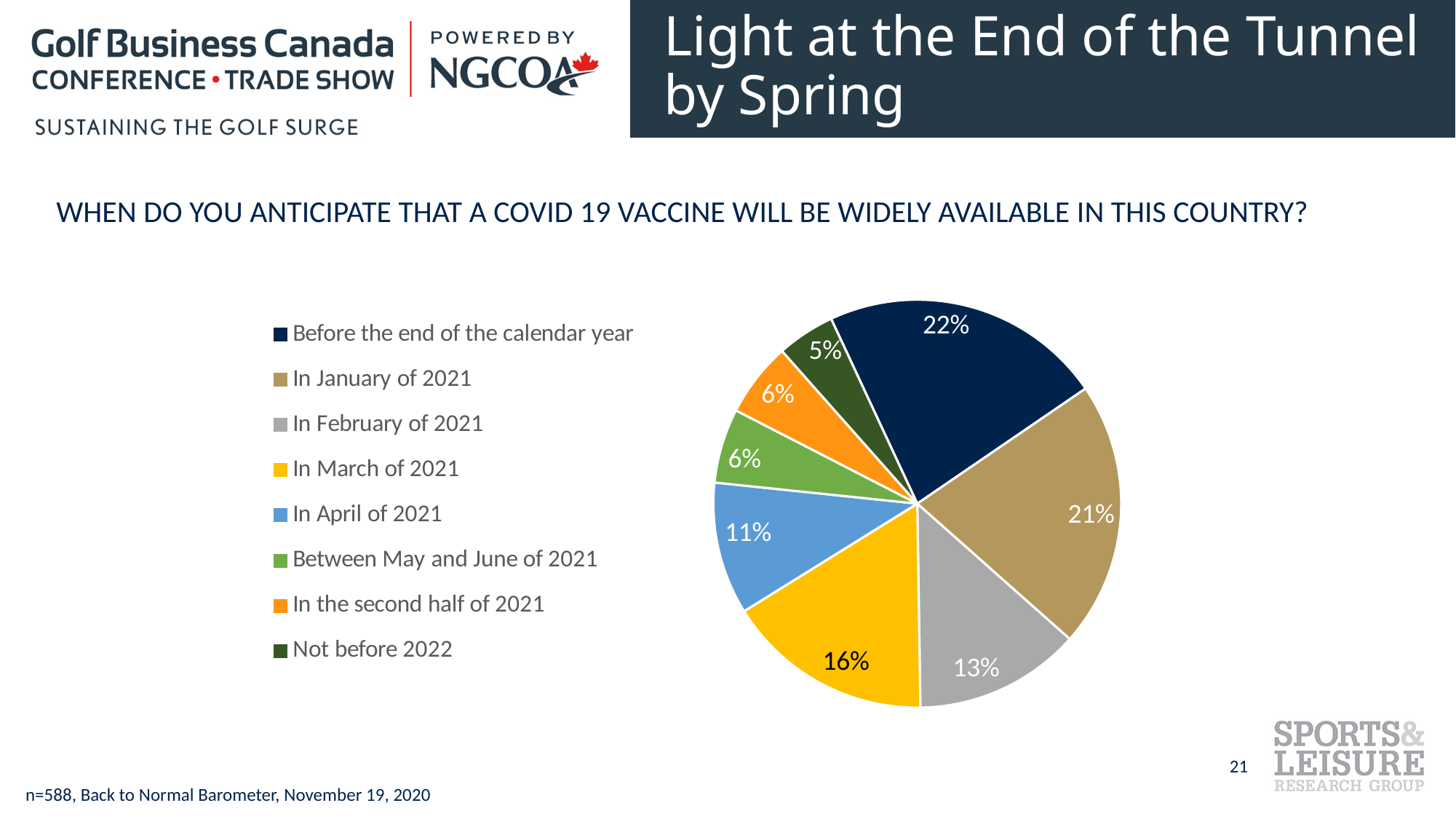
Which response has the largest share of the pie? Before the end of the calendar year What percentage of respondents chose 'Not before 2022'? 5% How many categories does the pie chart have? 8 Which is larger: the share for 'In March of 2021' or the share for 'In April of 2021'? In March of 2021 What share of respondents anticipate a vaccine will be widely available before the end of the calendar year? 22% Which response has the smallest share of the pie? Not before 2022 What kind of chart is shown on the slide? pie chart What percentage of respondents chose 'In March of 2021'? 16% What colour is the slice for 'In March of 2021'? yellow What percentage of respondents chose 'In April of 2021'? 11% What is the combined share of 'Between May and June of 2021' and 'In the second half of 2021'? 12% What is the difference in percentage points between 'In January of 2021' and 'In February of 2021'? 8